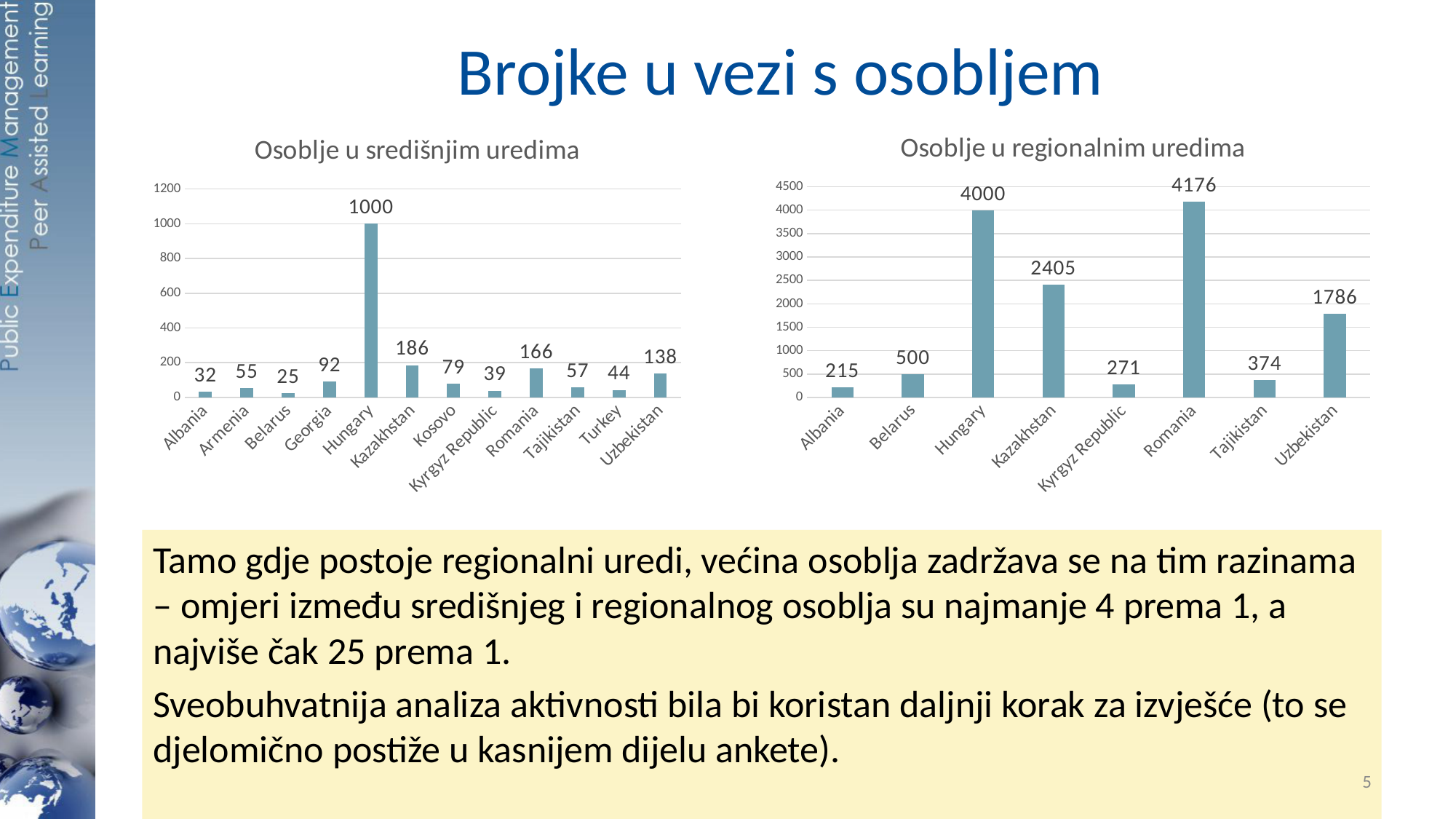
In the chart 'Osoblje u regionalnim uredima', what is the value for Romania? 4176 In the chart 'Osoblje u regionalnim uredima', how many countries are shown? 8 In the chart 'Osoblje u regionalnim uredima', what is the difference between Hungary and Kazakhstan? 1595 In the chart 'Osoblje u središnjim uredima', how many countries are shown? 12 In the chart 'Osoblje u središnjim uredima', what is the value for Kazakhstan? 186 What type of chart is 'Osoblje u regionalnim uredima'? Bar chart In the chart 'Osoblje u regionalnim uredima', which is larger, Kazakhstan or Uzbekistan? Kazakhstan In the chart 'Osoblje u regionalnim uredima', which country has the highest value? Romania In the chart 'Osoblje u središnjim uredima', which country has the lowest value? Belarus In the chart 'Osoblje u regionalnim uredima', which country has the lowest value? Albania In the chart 'Osoblje u središnjim uredima', what is the difference between Romania and Uzbekistan? 28 In the chart 'Osoblje u središnjim uredima', what is the value for Hungary? 1000